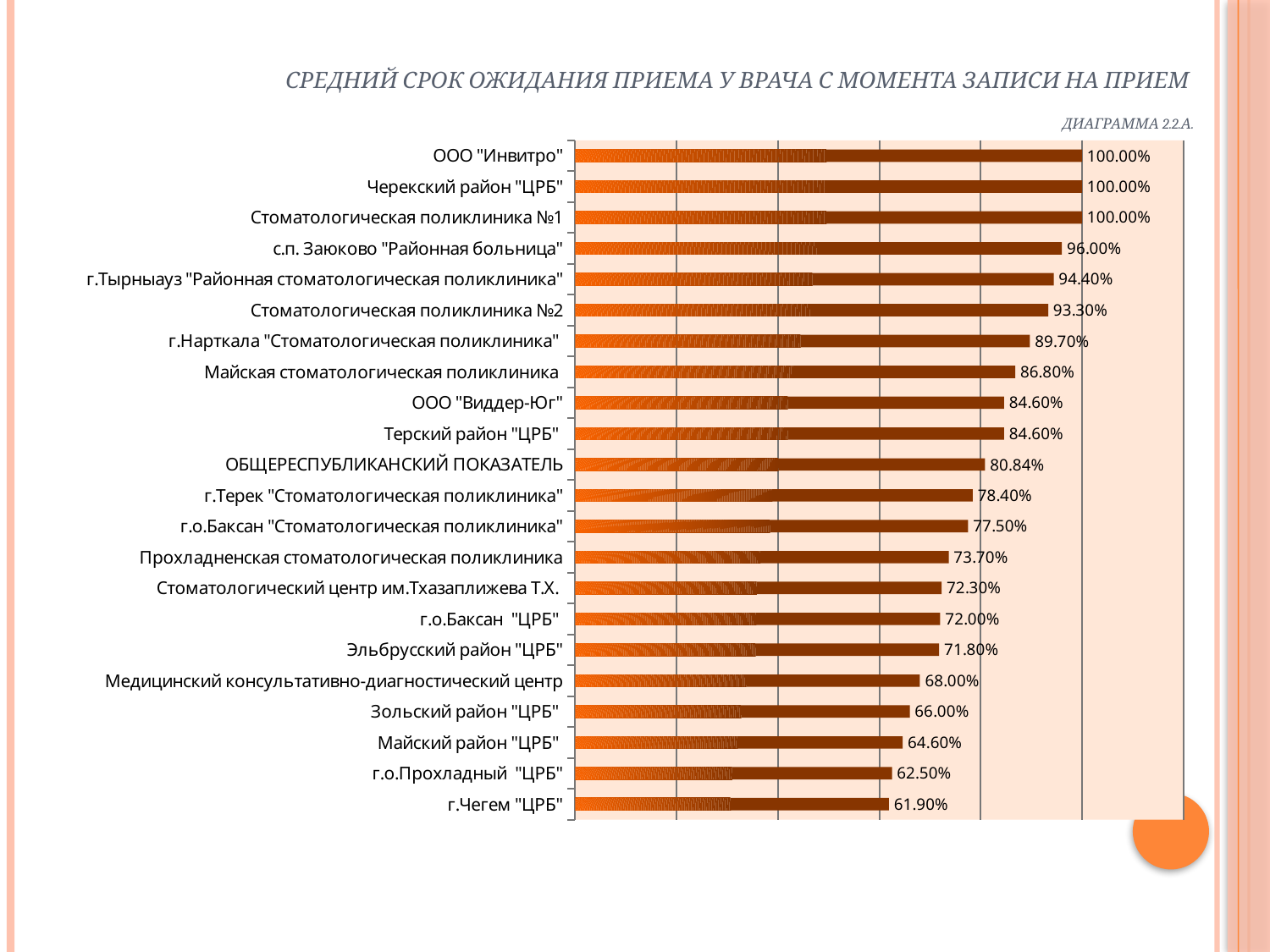
What is the value for Зольский район "ЦРБ"? 66.00% What is the value for с.п. Заюково "Районная больница"? 96.00% Which is larger, the value for г.о.Баксан "ЦРБ" or the value for Медицинский консультативно-диагностический центр? г.о.Баксан "ЦРБ" How many categories are plotted in the chart? 22 Which category has the lowest value? г.Чегем "ЦРБ" What is the difference between the values for Майская стоматологическая поликлиника and Майский район "ЦРБ"? 22.20% What kind of chart is shown on the slide? bar chart Which is larger, the value for Стоматологическая поликлиника №2 or the value for г.Терек "Стоматологическая поликлиника"? Стоматологическая поликлиника №2 What is the value for ОБЩЕРЕСПУБЛИКАНСКИЙ ПОКАЗАТЕЛЬ? 80.84% What is the title of the chart? СРЕДНИЙ СРОК ОЖИДАНИЯ ПРИЕМА У ВРАЧА С МОМЕНТА ЗАПИСИ НА ПРИЕМ What is the difference between the values for ООО "Инвитро" and г.Чегем "ЦРБ"? 38.10% What is the value for г.Нарткала "Стоматологическая поликлиника"? 89.70%